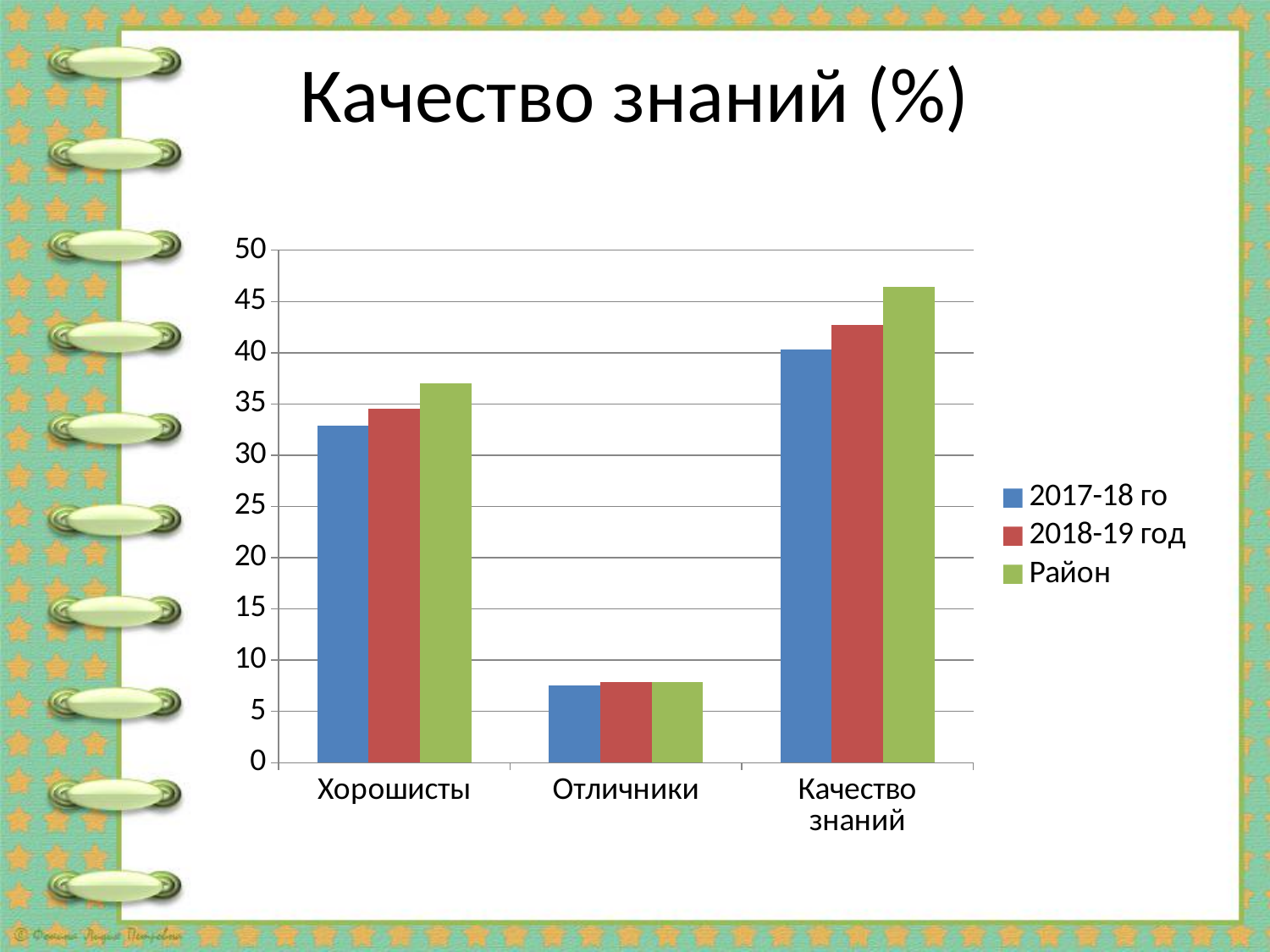
Is the value for Качество знаний in the Район series greater or less than 45? greater How many series does the legend list? 3 For Качество знаний, which is larger: the 2017-18 го value or the 2018-19 год value? 2018-19 год For the 2018-19 год series, which category has the lowest value? Отличники What is the title of the chart? Качество знаний (%) How many categories are shown on the x axis? 3 Is the value for Хорошисты in the 2017-18 го series greater or less than 30? greater Is the value for Отличники in the 2017-18 го series greater or less than 10? less What kind of chart is shown on the slide? bar chart For the Район series, which category has the highest value? Качество знаний Which series is shown in green in the legend? Район